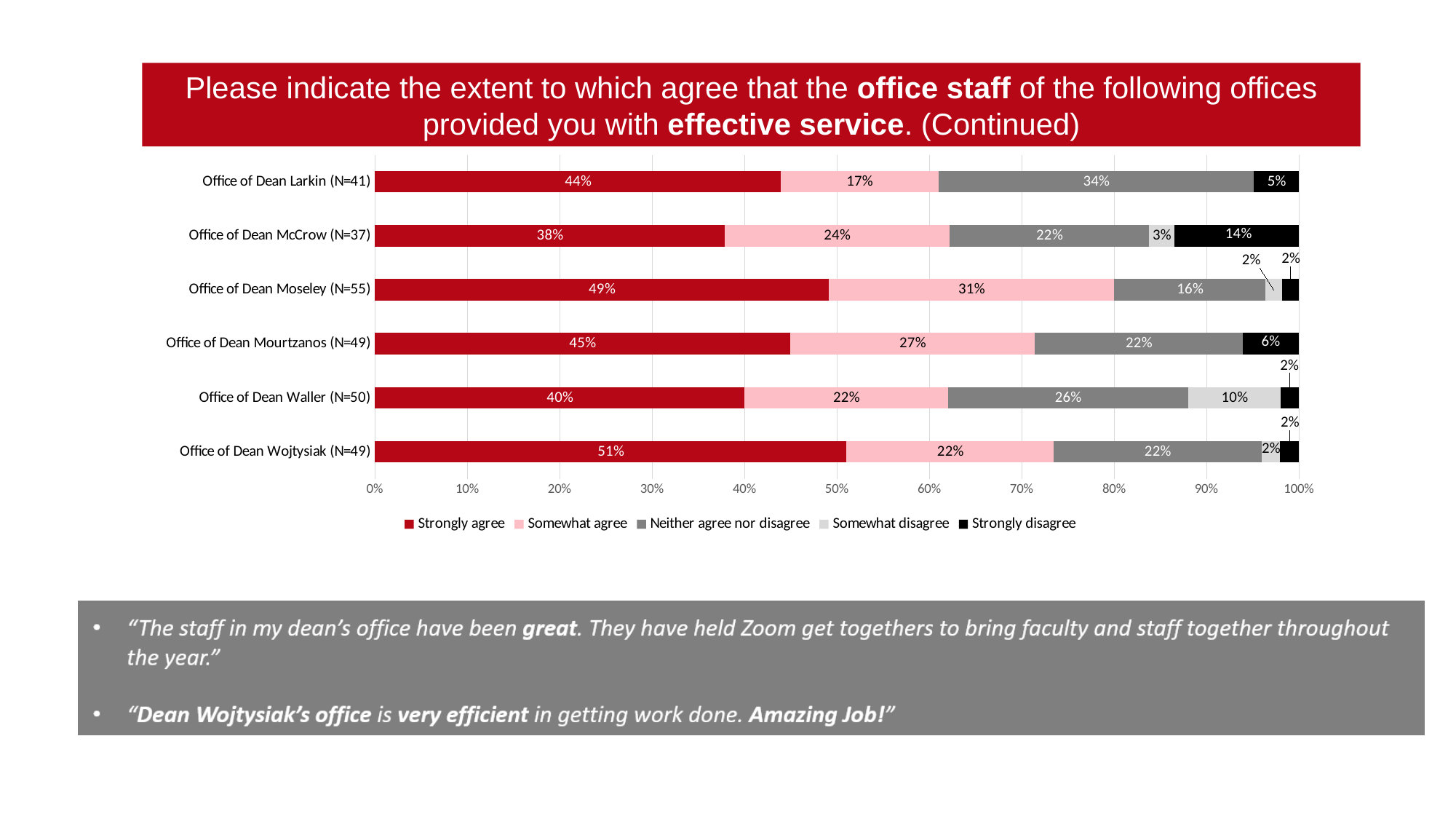
Which office has the highest Neither agree nor disagree percentage? Office of Dean Larkin (N=41) How many response categories does the legend list? 5 What type of chart is shown on the slide? Stacked bar chart Which office has the lowest Strongly agree percentage? Office of Dean McCrow (N=37) What is the Somewhat disagree value for the Office of Dean Waller (N=50)? 10% How many offices are shown in the chart? 6 What percentage of respondents strongly agree for the Office of Dean Moseley (N=55)? 49% Which office has the highest Strongly agree percentage? Office of Dean Wojtysiak (N=49) Which has a larger Neither agree nor disagree share, the Office of Dean Larkin or the Office of Dean Waller? Office of Dean Larkin What is the Strongly disagree value for the Office of Dean McCrow (N=37)? 14% What is the difference in Somewhat agree percentage between the Office of Dean Moseley and the Office of Dean Larkin? 14 percentage points Which colour represents Strongly agree in the chart? Dark red